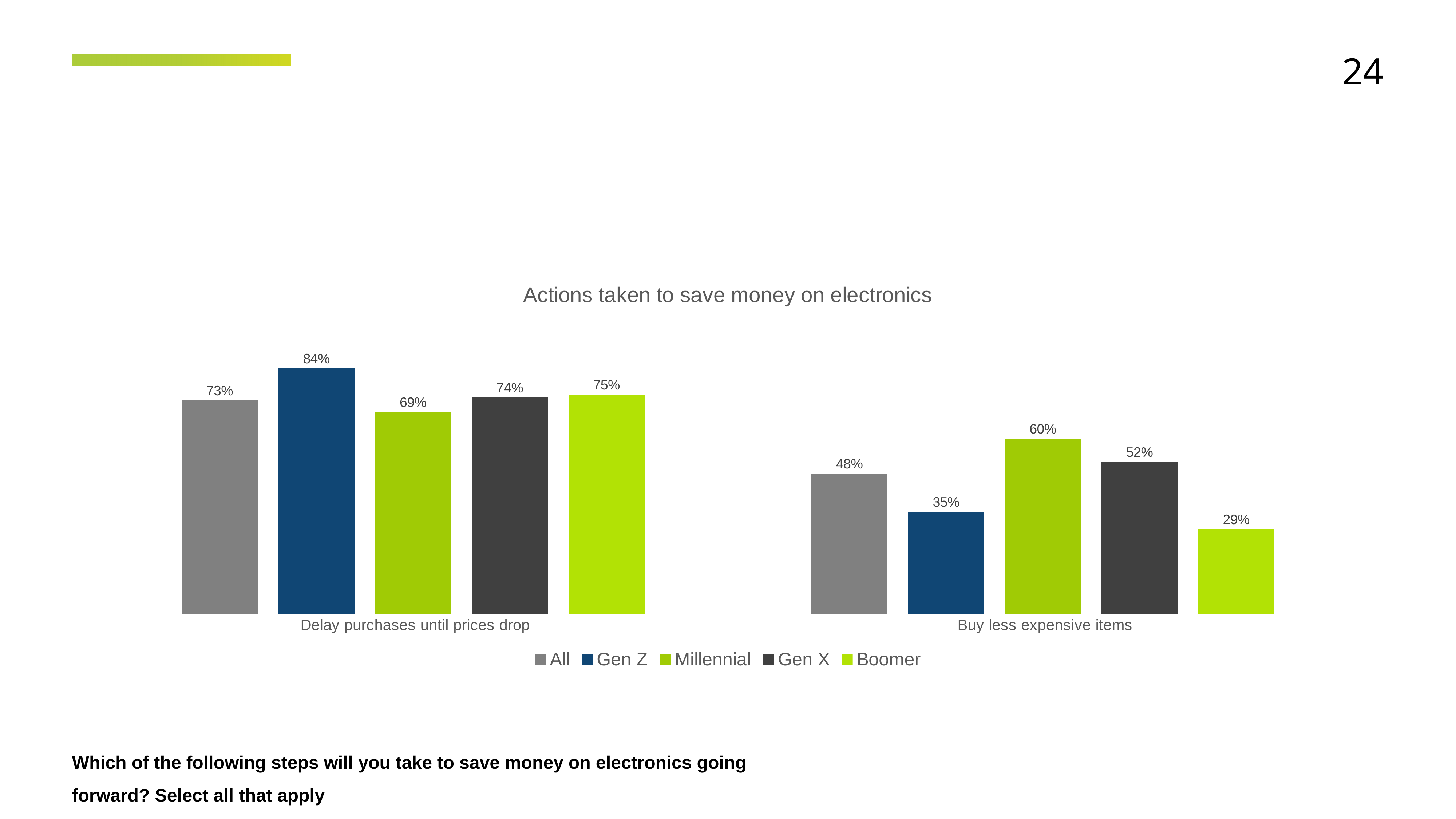
Which is larger for 'Buy less expensive items': Gen X or Gen Z? Gen X What is the value for Gen Z for 'Delay purchases until prices drop'? 84% What is the value for Millennial for 'Buy less expensive items'? 60% What is the value for All for 'Buy less expensive items'? 48% Which series has the highest value for 'Delay purchases until prices drop'? Gen Z How many categories are shown on the x axis? 2 What is the difference between the Gen Z and Millennial values for 'Delay purchases until prices drop'? 15% How many series does the legend list? 5 What kind of chart is shown on the slide? Bar chart What is the title of the chart? Actions taken to save money on electronics Which series has the lowest value for 'Buy less expensive items'? Boomer What is the value for Boomer for 'Buy less expensive items'? 29%